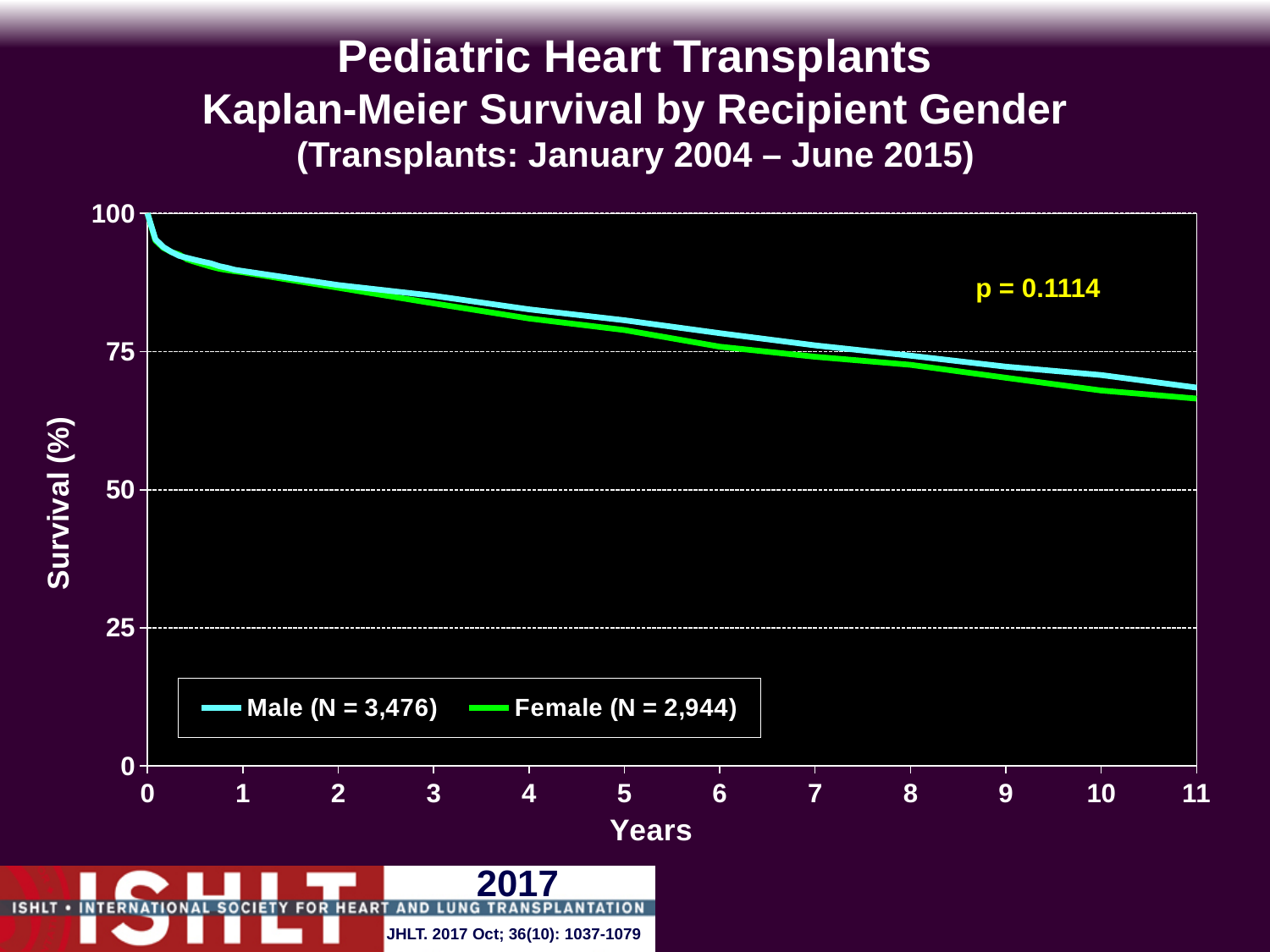
What kind of chart is shown on the slide? Line chart Do the survival curves rise or fall as the years increase? Fall What is the p-value printed on the chart? p = 0.1114 Is the survival for Male at 1 year greater or less than 75? greater Is the survival for Female at 3 years greater or less than 75? greater At 10 years, which series has the higher survival, Male or Female? Male How many series does the legend list? 2 Is the survival for Female at 10 years greater or less than 75? less What is the maximum value shown on the Years axis? 11 What is the N for the Male series in the legend? 3,476